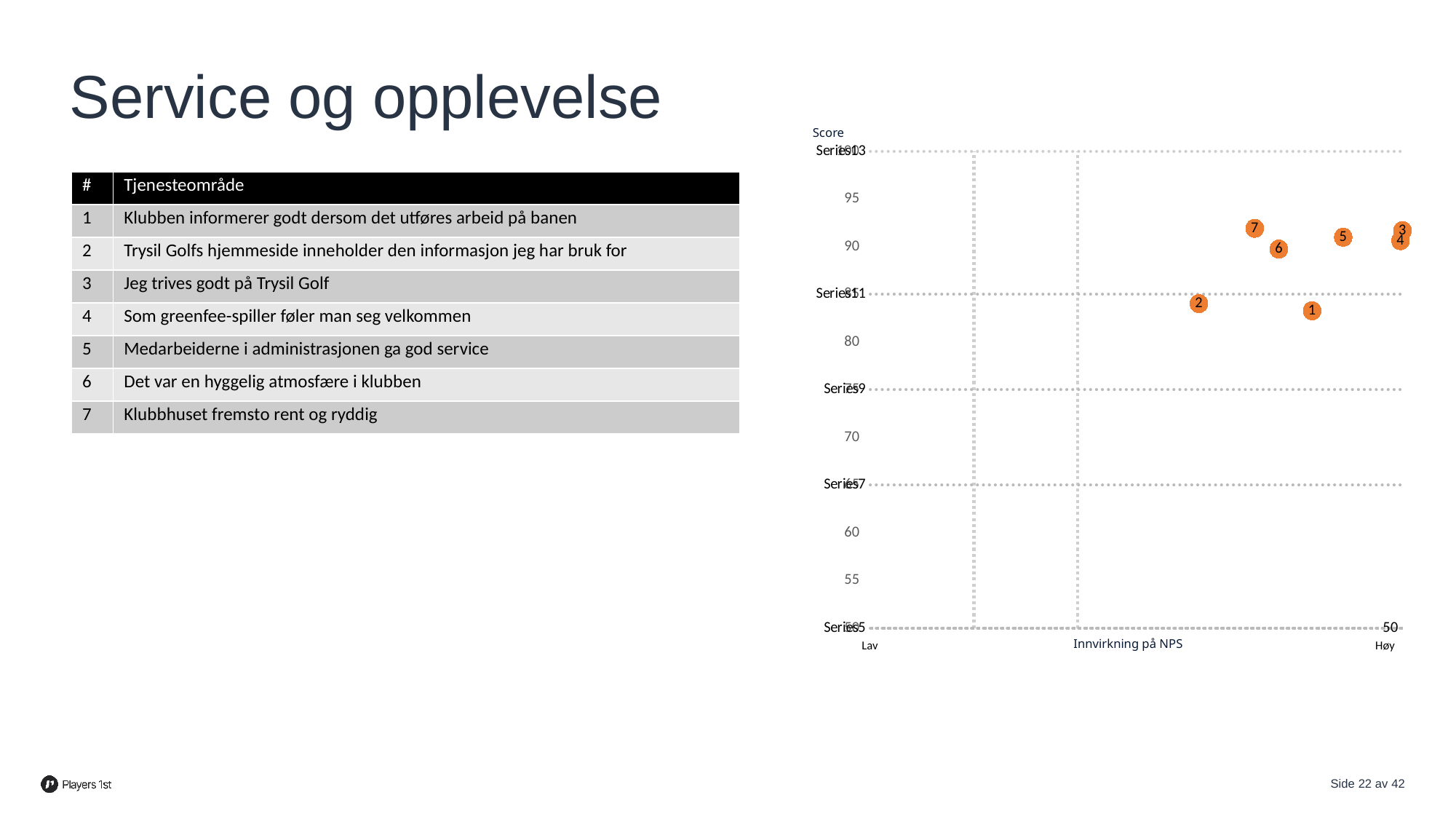
What kind of chart is shown on the slide? scatter chart Is the score for point 2 greater or less than 80? greater Is the score for point 3 greater or less than 90? greater Is the score for point 7 greater or less than 90? greater What is the title of the vertical axis of the chart? Score Which has the higher score, point 7 or point 1? point 7 How many numbered points are plotted in the chart? 7 Which has the higher score, point 5 or point 2? point 5 What is the title of the horizontal axis of the chart? Innvirkning på NPS